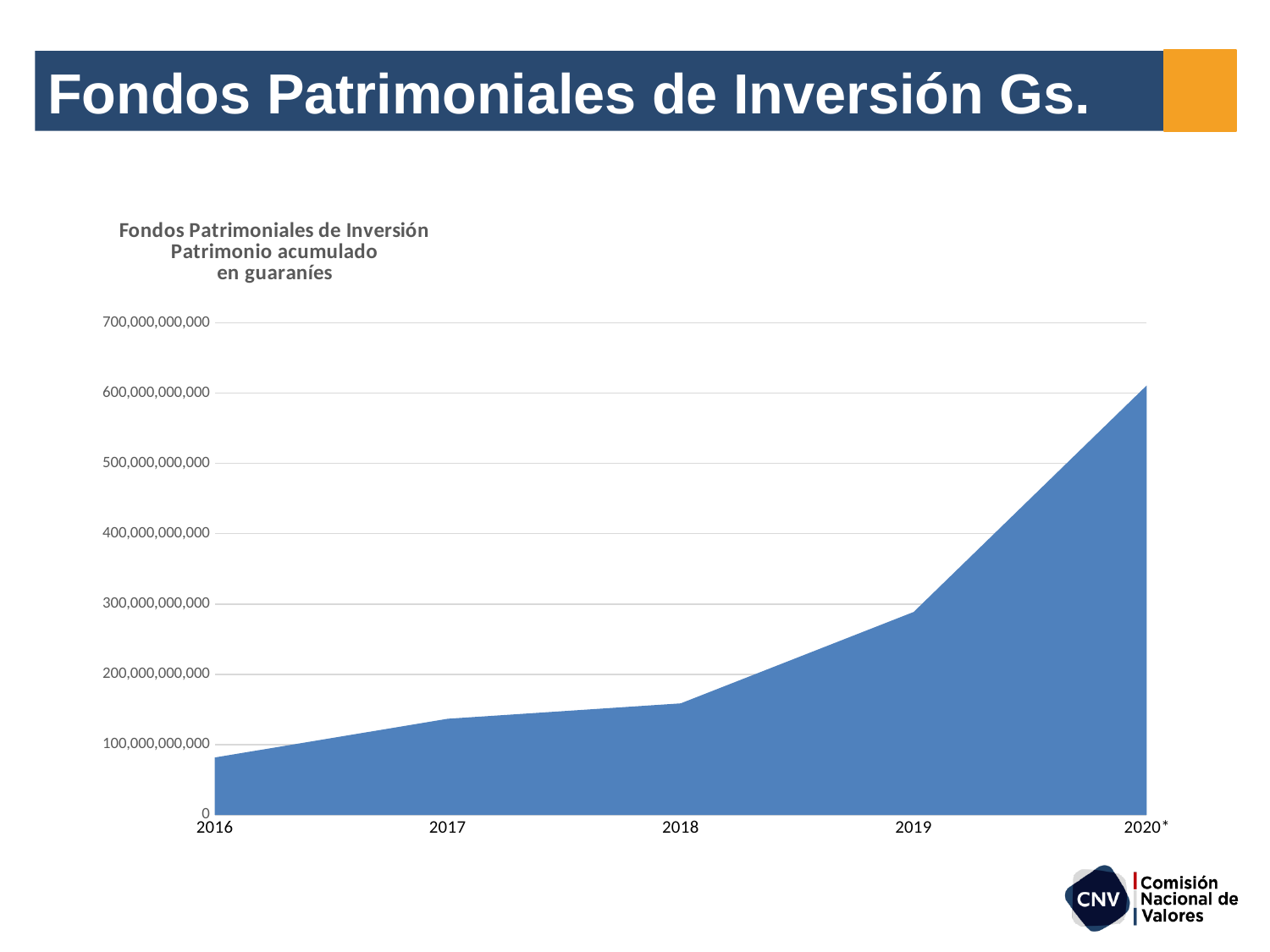
Which year has the lowest accumulated patrimony in the chart? 2016 What is the title of the chart? Fondos Patrimoniales de Inversión Patrimonio acumulado en guaraníes What is the highest value shown on the y axis of the chart? 700,000,000,000 Do the values rise or fall from 2016 to 2020* in the chart? Rise What kind of chart is shown on the slide? Area chart Is the value for 2019 greater or less than 200,000,000,000? greater Is the value for 2018 greater or less than 200,000,000,000? less How many years are plotted along the x axis of the chart? 5 Is the value for 2020* greater or less than 500,000,000,000? greater Which year has a larger value, 2019 or 2017? 2019 Which year has the highest accumulated patrimony in the chart? 2020*